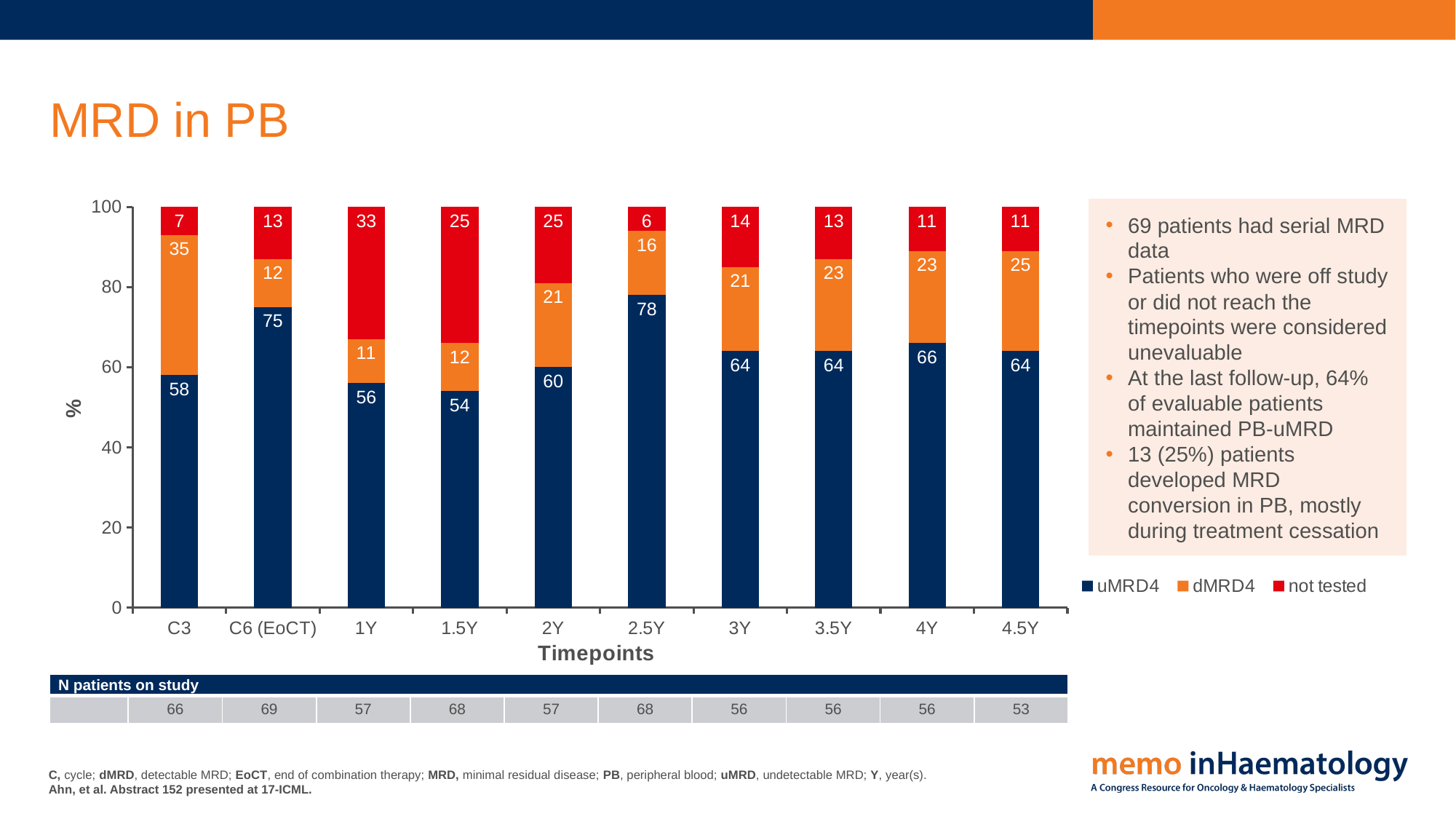
At which timepoint is the 'not tested' value lowest? 2.5Y How many timepoints are shown on the x axis? 10 At which timepoint is the uMRD4 value lowest? 1.5Y Which is larger, the dMRD4 value at 4.5Y or at 3Y? 4.5Y At which timepoint is the uMRD4 value highest? 2.5Y What kind of chart is shown on the slide? Stacked bar chart What is the dMRD4 value at C3? 35 What is the difference between the uMRD4 values at 2.5Y and 1.5Y? 24 What is the uMRD4 value at the 2.5Y timepoint? 78 What is the uMRD4 value at C6 (EoCT)? 75 What is the 'not tested' value at the 1Y timepoint? 33 How many series does the legend list? 3